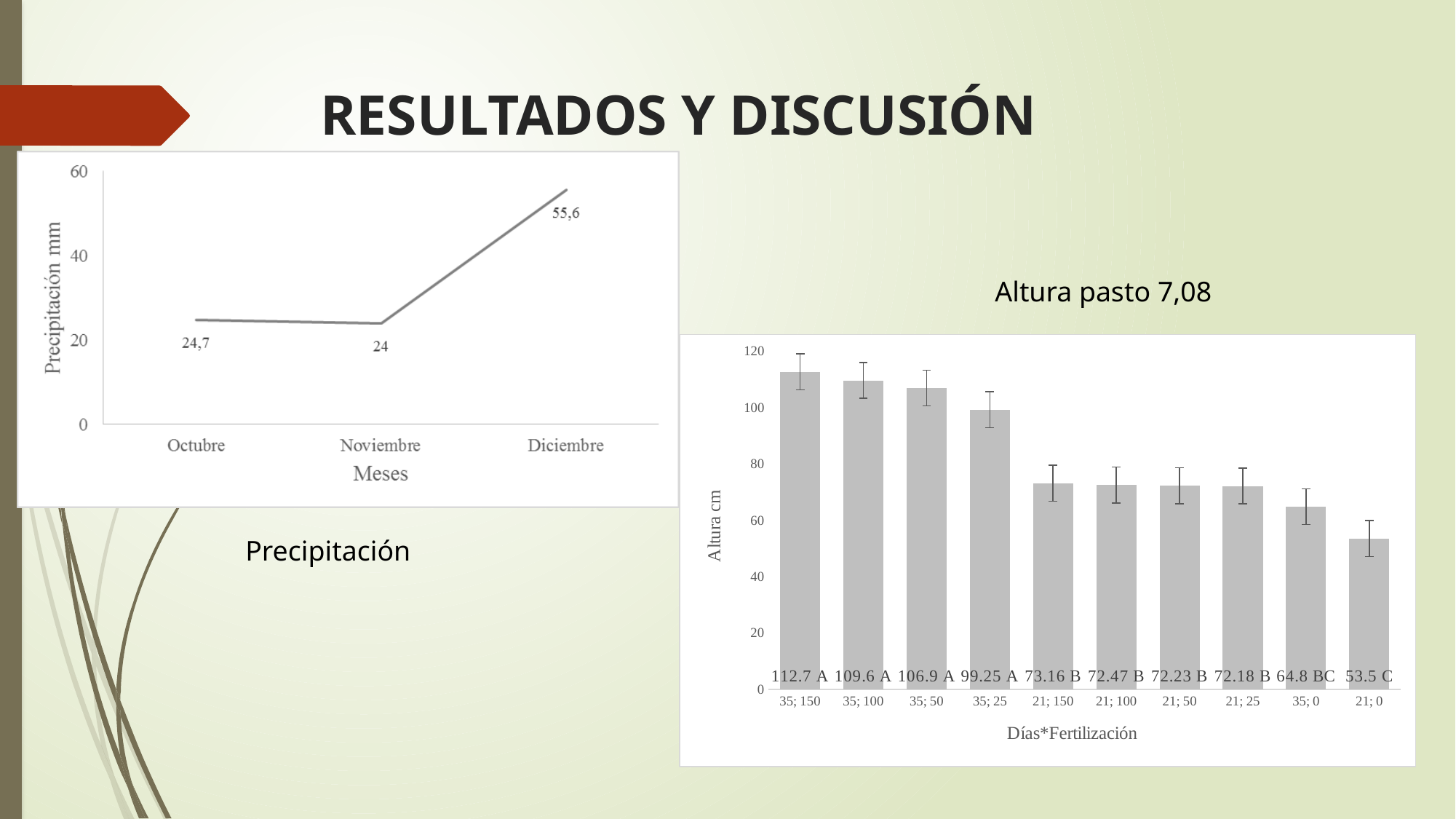
In the Altura pasto chart, what is the data label for the bar 35; 150? 112.7 A In the Precipitación chart, what is the difference in precipitation between Diciembre and Noviembre? 31,6 In the Precipitación chart, what kind of chart is shown? Line chart In the Precipitación chart, which month has the lowest precipitation? Noviembre In the Precipitación chart, what is the precipitation value for Octubre? 24,7 In the Altura pasto chart, how many bars are shown? 10 In the Altura pasto chart, which category has the lowest height? 21; 0 In the Precipitación chart, what is the precipitation value for Diciembre? 55,6 In the Precipitación chart, how many months are plotted on the x axis? 3 In the Altura pasto chart, what is the x-axis title? Días*Fertilización In the Altura pasto chart, which is larger, the value for 35; 25 or the value for 21; 150? 35; 25 In the Precipitación chart, which month has the highest precipitation? Diciembre